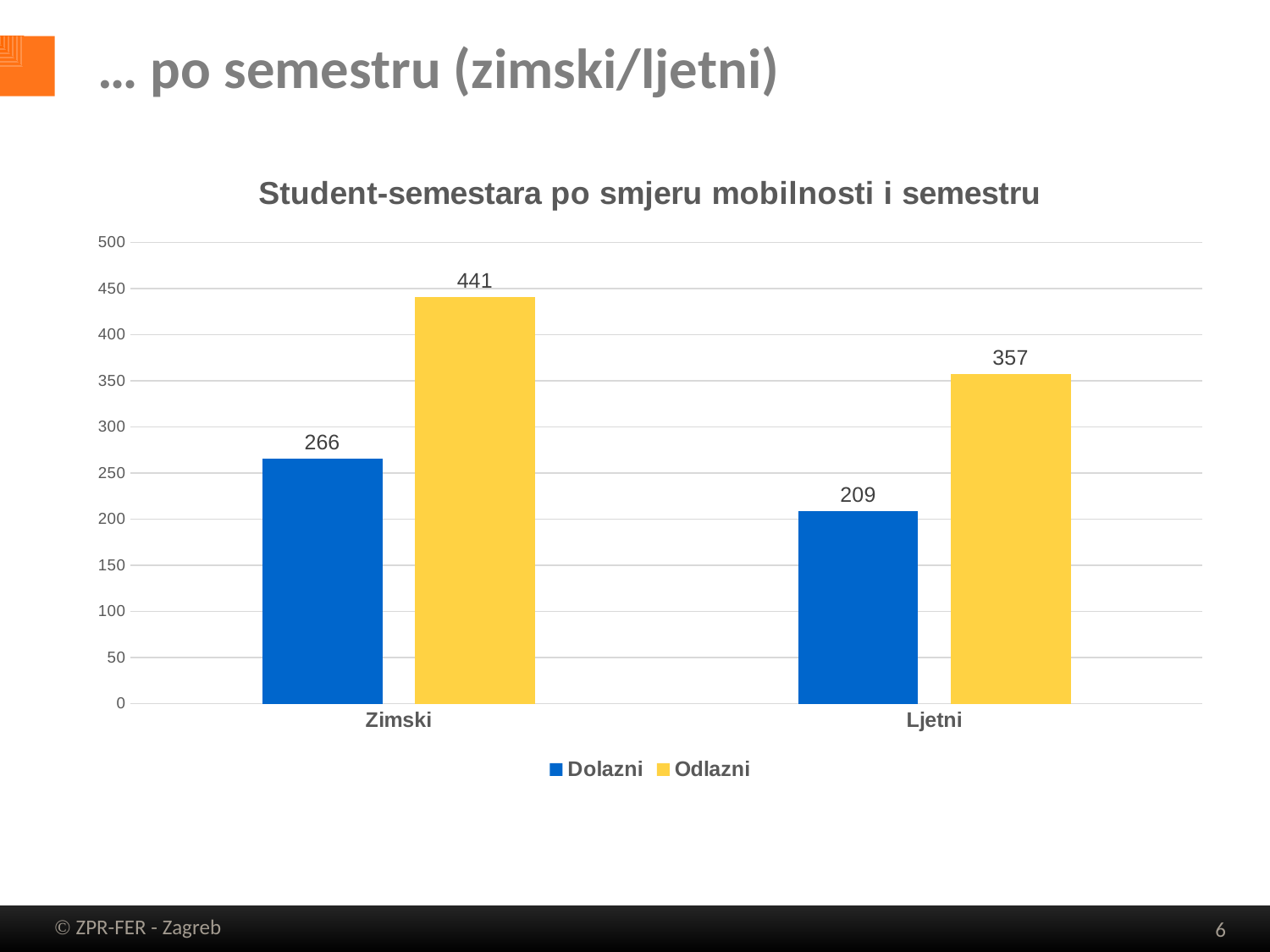
What is the value for Dolazni in the Zimski semester? 266 What is the value for Odlazni in the Ljetni semester? 357 Which is larger: Dolazni in Zimski or Dolazni in Ljetni? Dolazni in Zimski How many series does the legend list? 2 What is the difference between Odlazni and Dolazni in the Ljetni semester? 148 What is the difference between Odlazni and Dolazni in the Zimski semester? 175 Which bar has the lowest value on the chart? Dolazni, Ljetni Which bar has the highest value on the chart? Odlazni, Zimski Is the value for Odlazni in Ljetni greater or less than 400? less What is the value for Odlazni in the Zimski semester? 441 What kind of chart is shown on the slide? bar chart What is the title of the chart? Student-semestara po smjeru mobilnosti i semestru